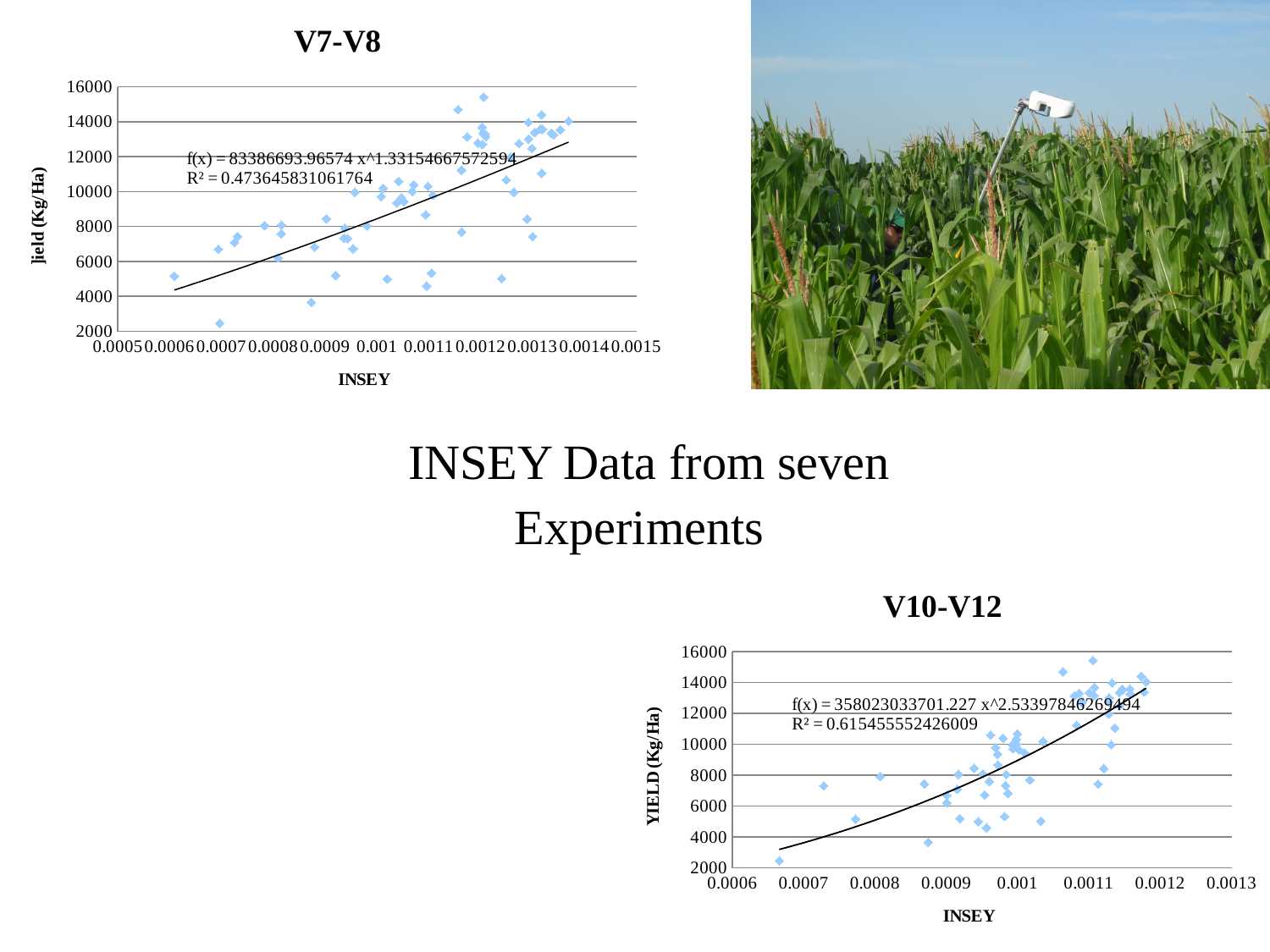
What R² value is printed on the V7-V8 chart? 0.473645831061764 What is the fitted equation printed on the V10-V12 chart? f(x) = 358023033701.227 x^2.53397846269494 In the V10-V12 chart, is the lowest plotted yield greater or less than 4000? less In the V10-V12 chart, does yield generally rise or fall as INSEY increases along the x axis? Rise What is the y-axis title of the V10-V12 chart? YIELD (Kg/Ha) In the V7-V8 chart, does yield generally rise or fall as INSEY increases along the x axis? Rise What R² value is printed on the V10-V12 chart? 0.615455552426009 What is the x-axis title of the V7-V8 chart? INSEY Which chart has the higher R² value, V7-V8 or V10-V12? V10-V12 What kind of chart is the V7-V8 chart? Scatter chart In the V7-V8 chart, is the highest plotted yield greater or less than 14000? greater What kind of chart is the V10-V12 chart? Scatter chart